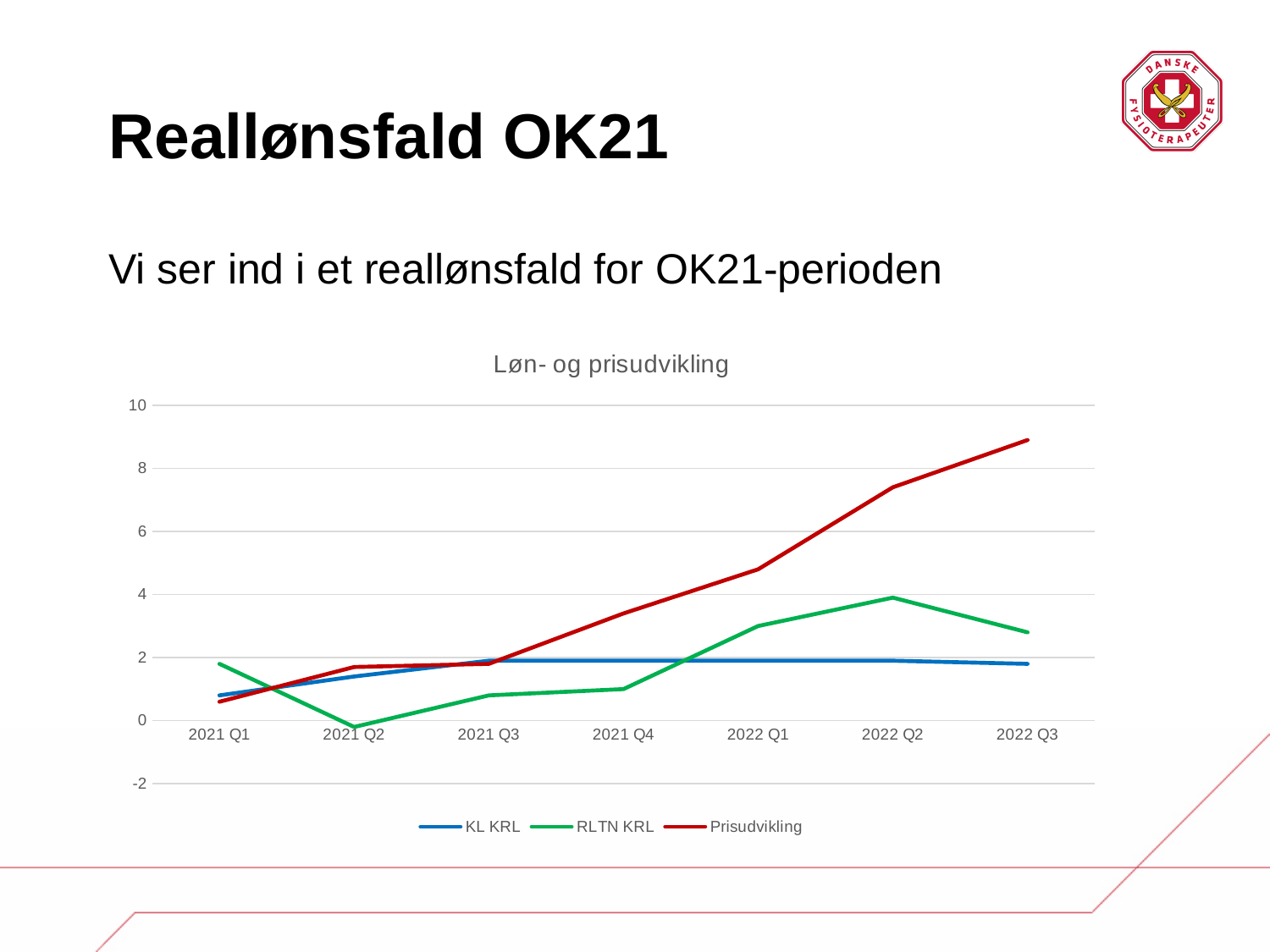
What is the title of the chart? Løn- og prisudvikling Does the Prisudvikling series rise or fall from 2021 Q1 to 2022 Q3? rise Is the value for Prisudvikling in 2022 Q3 greater or less than 8? greater In which quarter does the Prisudvikling series reach its highest value? 2022 Q3 Is the value for KL KRL in 2022 Q1 greater or less than 4? less In which quarter does the RLTN KRL series reach its highest value? 2022 Q2 How many quarters are shown on the x axis? 7 In 2022 Q3, which is larger: Prisudvikling or RLTN KRL? Prisudvikling In which quarter does the RLTN KRL series reach its lowest value? 2021 Q2 What kind of chart is shown on the slide? line chart Which series is drawn in red? Prisudvikling How many series does the legend list? 3